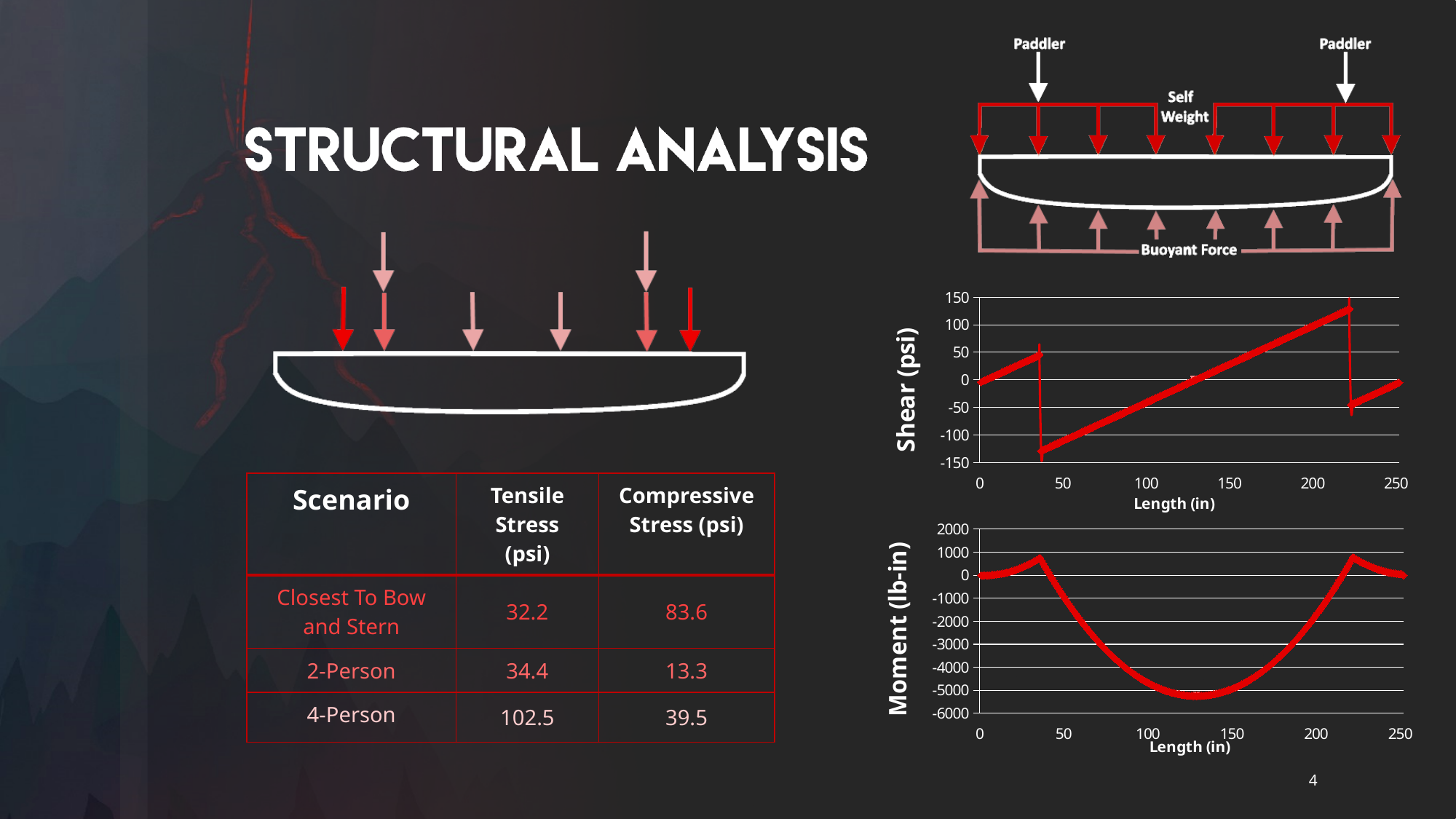
In the Moment (lb-in) chart, does the moment rise or fall as length increases from 150 in to 220 in? rise What kind of chart is the lower chart on the right, with Moment (lb-in) on the vertical axis? line chart In the Moment (lb-in) chart, is the moment at a length of 125 in greater or less than -4000? less In the Shear (psi) chart, does the shear rise or fall as length increases from 50 in to 200 in? rise What kind of chart is the upper chart on the right, with Shear (psi) on the vertical axis? line chart In the Moment (lb-in) chart, what is the highest value shown on the vertical axis? 2000 In the Moment (lb-in) chart, is the moment at a length of 100 in greater or less than -2000? less In the Shear (psi) chart, is the shear value at a length of 100 in greater or less than 0? less In the Moment (lb-in) chart, is the moment at a length of 125 in larger or smaller than the moment at a length of 50 in? smaller In the Shear (psi) chart, what is the label of the horizontal axis? Length (in) In the Moment (lb-in) chart, does the moment rise or fall as length increases from 50 in to 125 in? fall